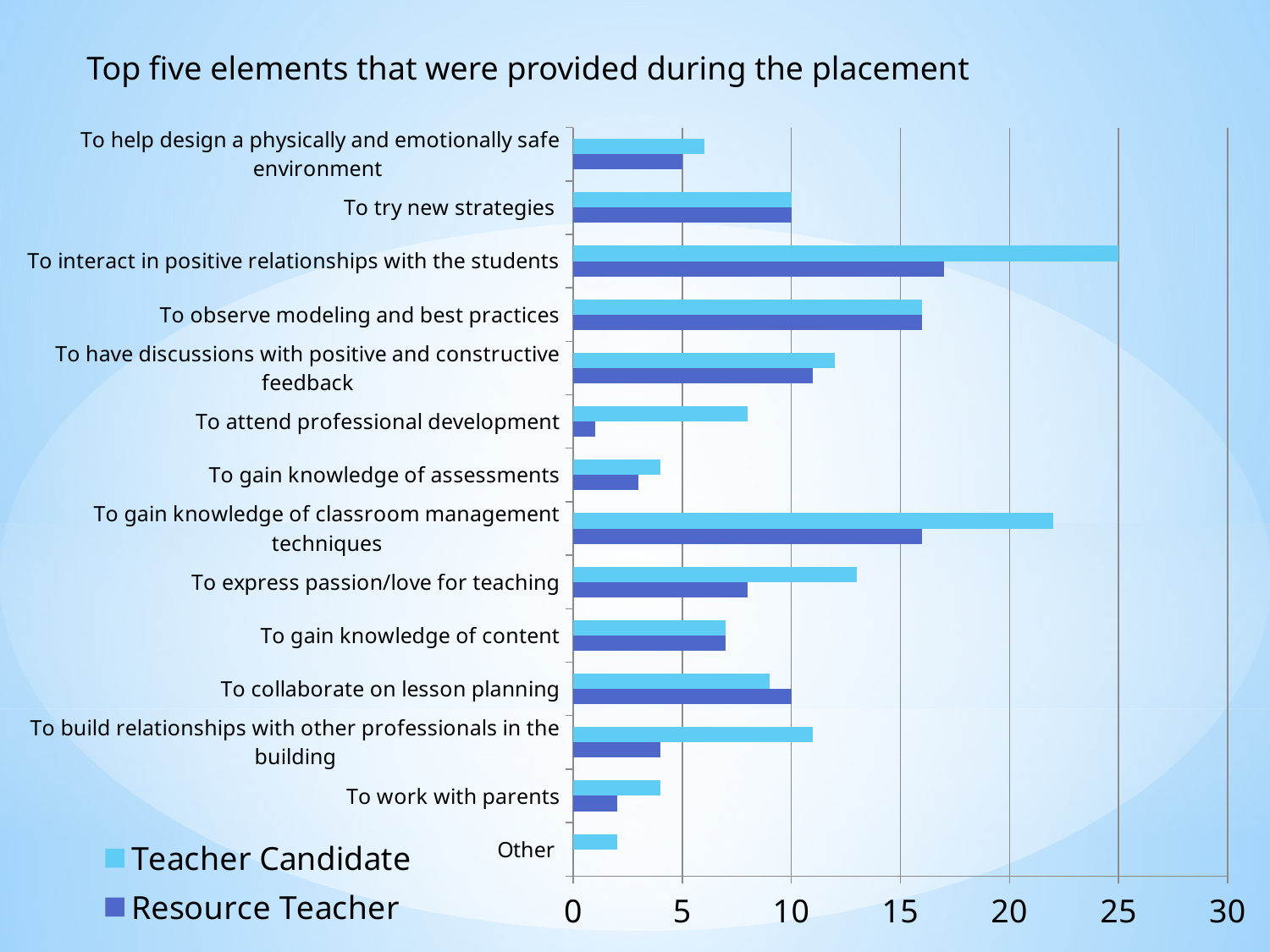
What is the Teacher Candidate value for 'To interact in positive relationships with the students'? 25 Which category has the lowest Resource Teacher value? Other How many series does the legend list? 2 What is the Teacher Candidate value for 'To try new strategies'? 10 What kind of chart is shown on the slide? bar chart For 'To build relationships with other professionals in the building', which series has the larger value, Teacher Candidate or Resource Teacher? Teacher Candidate What is the Resource Teacher value for 'To collaborate on lesson planning'? 10 Is the Resource Teacher value for 'To attend professional development' greater or less than 5? less Which category has the highest Teacher Candidate value? To interact in positive relationships with the students What is the title of the chart? Top five elements that were provided during the placement Is the Teacher Candidate value for 'To gain knowledge of classroom management techniques' greater or less than 20? greater How many categories are plotted on the chart? 14